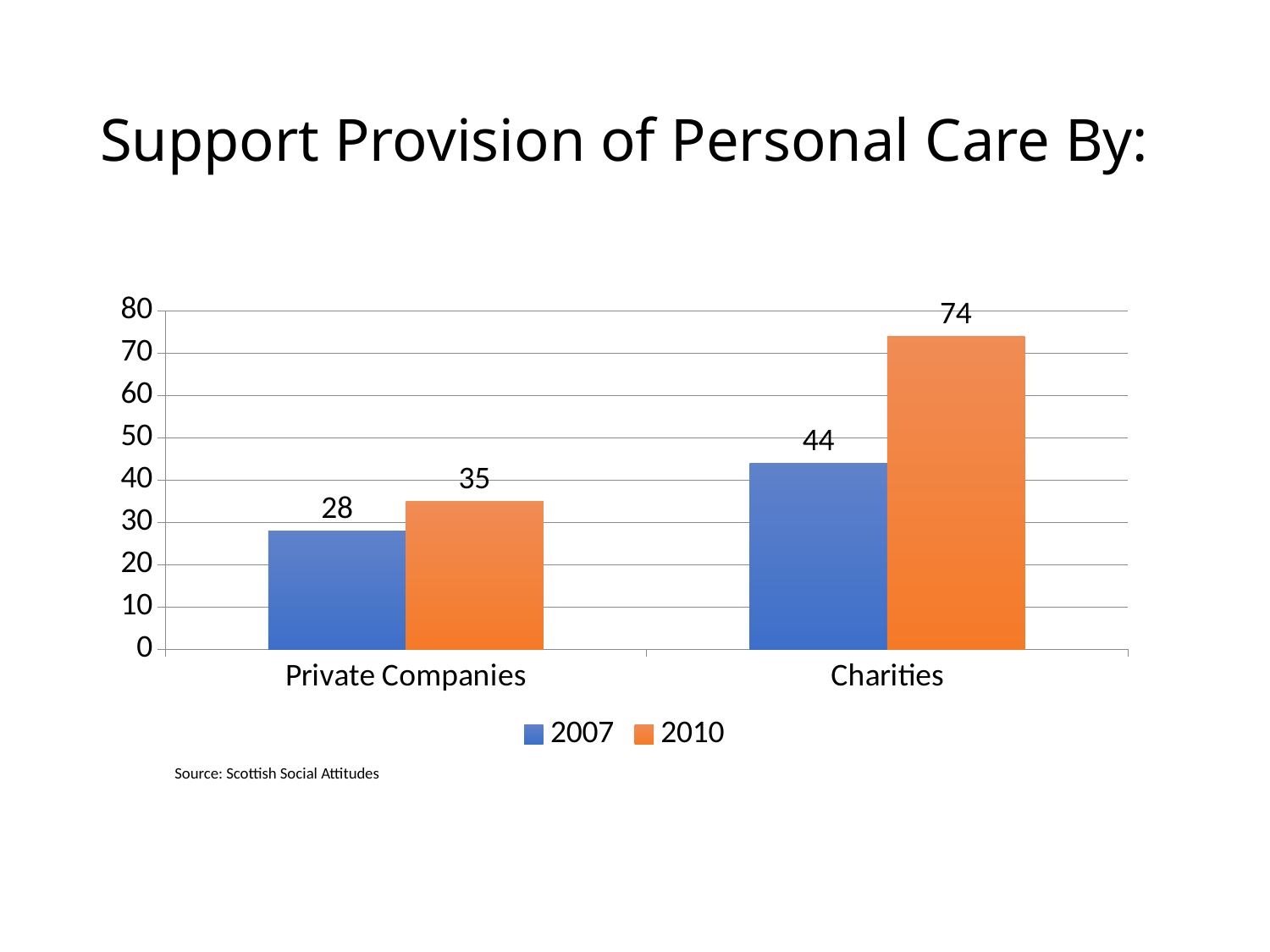
Which category has the highest value in 2010? Charities What is the difference between the 2010 and 2007 values for Private Companies? 7 Which is larger: the 2007 value for Charities or the 2010 value for Private Companies? 2007 value for Charities What is the value for Private Companies in 2007? 28 What is the value for Private Companies in 2010? 35 What kind of chart is shown on the slide? Bar chart How many series does the legend list? 2 Which category has the lowest value in 2007? Private Companies What is the value for Charities in 2010? 74 What is the value for Charities in 2007? 44 How many categories are shown on the x axis? 2 What is the difference between the 2010 and 2007 values for Charities? 30